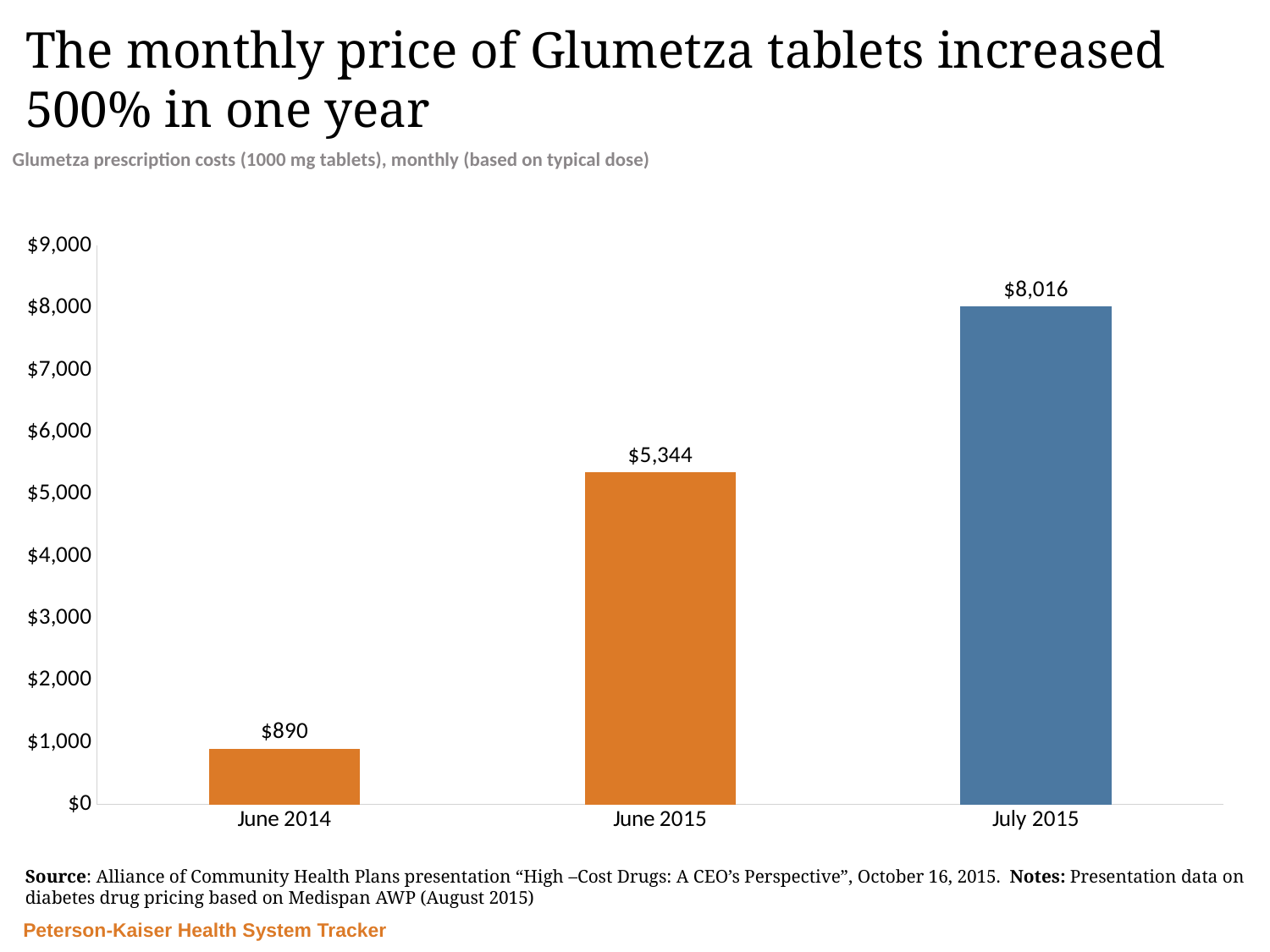
How many months are shown on the x axis of the chart? 3 Which month has the lowest monthly Glumetza prescription cost? June 2014 What is the monthly Glumetza prescription cost for July 2015? $8,016 Which is larger, the monthly cost in June 2014 or in June 2015? June 2015 What is the monthly Glumetza prescription cost for June 2015? $5,344 Which month has the highest monthly Glumetza prescription cost? July 2015 Is the value for July 2015 greater or less than $7,000? greater What is the difference between the July 2015 and June 2015 monthly costs? $2,672 Do the monthly costs rise or fall from June 2014 to July 2015? Rise What is the difference between the June 2015 and June 2014 monthly costs? $4,454 What kind of chart is shown on the slide? Bar chart What is the monthly Glumetza prescription cost for June 2014? $890